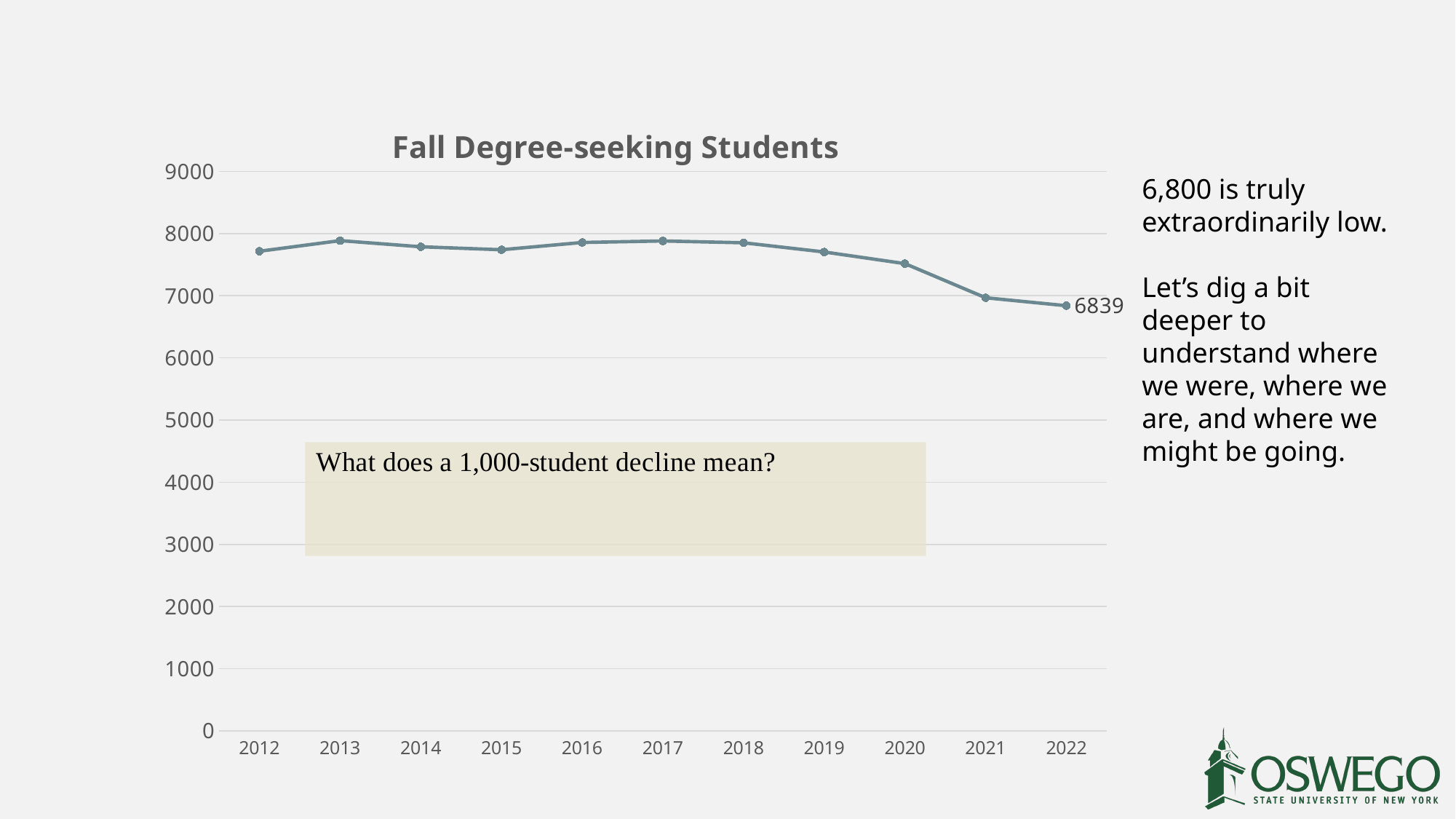
Is the value for 2012 greater or less than 7000? greater What is the value for 2022? 6839 Which is larger, the value for 2013 or the value for 2021? 2013 How many years are plotted on the x axis? 11 What is the title of the chart? Fall Degree-seeking Students Which year has the lowest value? 2022 Which is larger, the value for 2020 or the value for 2022? 2020 Is the value for 2017 greater or less than 8000? less Do the values rise or fall from 2018 to 2022? fall Is the value for 2013 greater or less than 8000? less What type of chart is shown on the slide? line chart